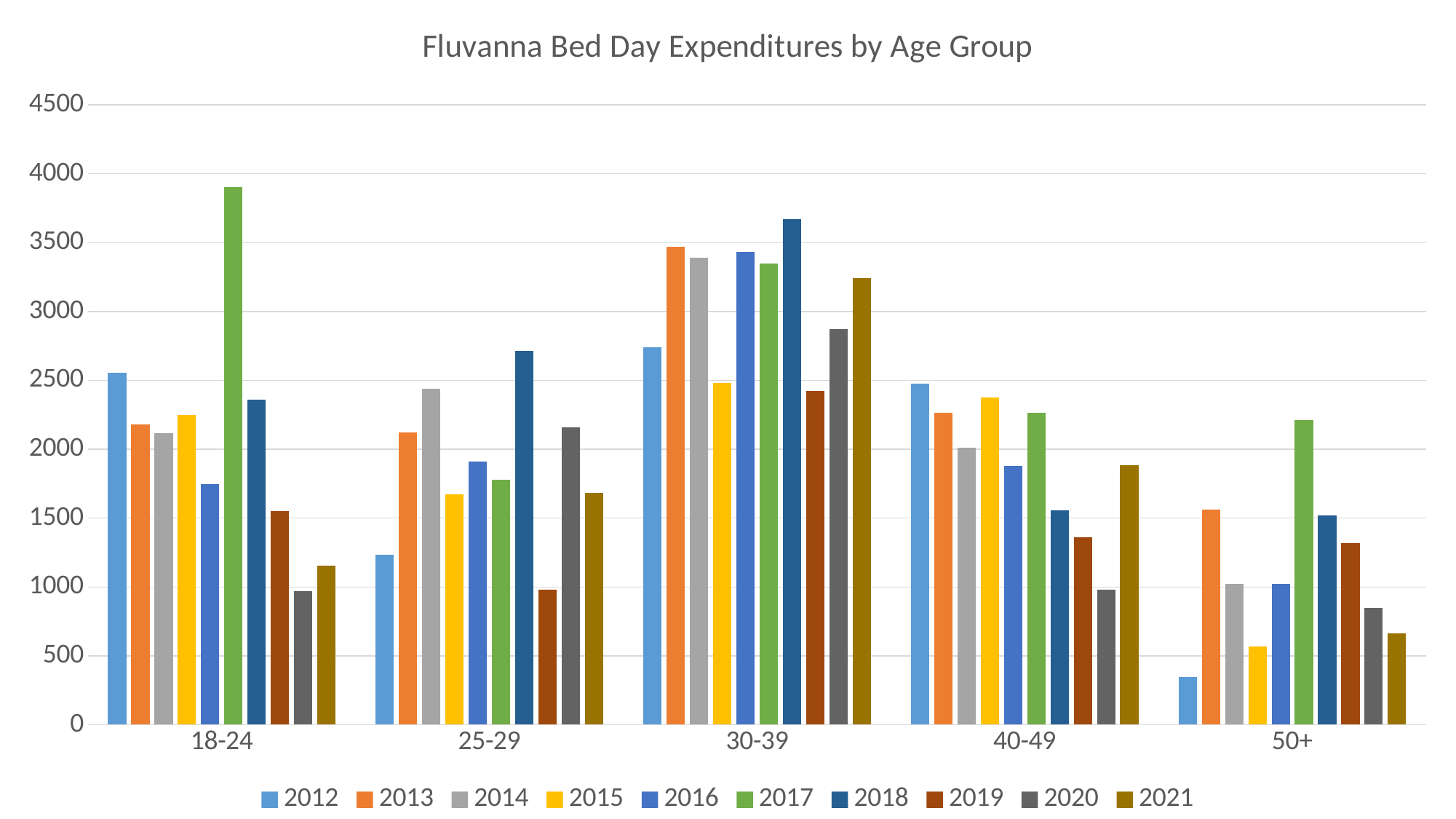
How many series does the legend list? 10 Is the value for 2017 in the 18-24 age group greater or less than 3500? greater In the 25-29 age group, which is larger: the 2018 bar or the 2012 bar? 2018 In the 50+ age group, which is larger: the 2013 bar or the 2015 bar? 2013 What kind of chart is shown on the slide? bar chart Is the value for 2018 in the 30-39 age group greater or less than 3500? greater What is the title of the chart? Fluvanna Bed Day Expenditures by Age Group Is the value for 2012 in the 50+ age group greater or less than 500? less Which age group has the highest bar for 2017? 18-24 Which age group has the lowest bar for 2012? 50+ How many age groups are shown on the x axis? 5 Within the 30-39 age group, which year has the highest bar? 2018